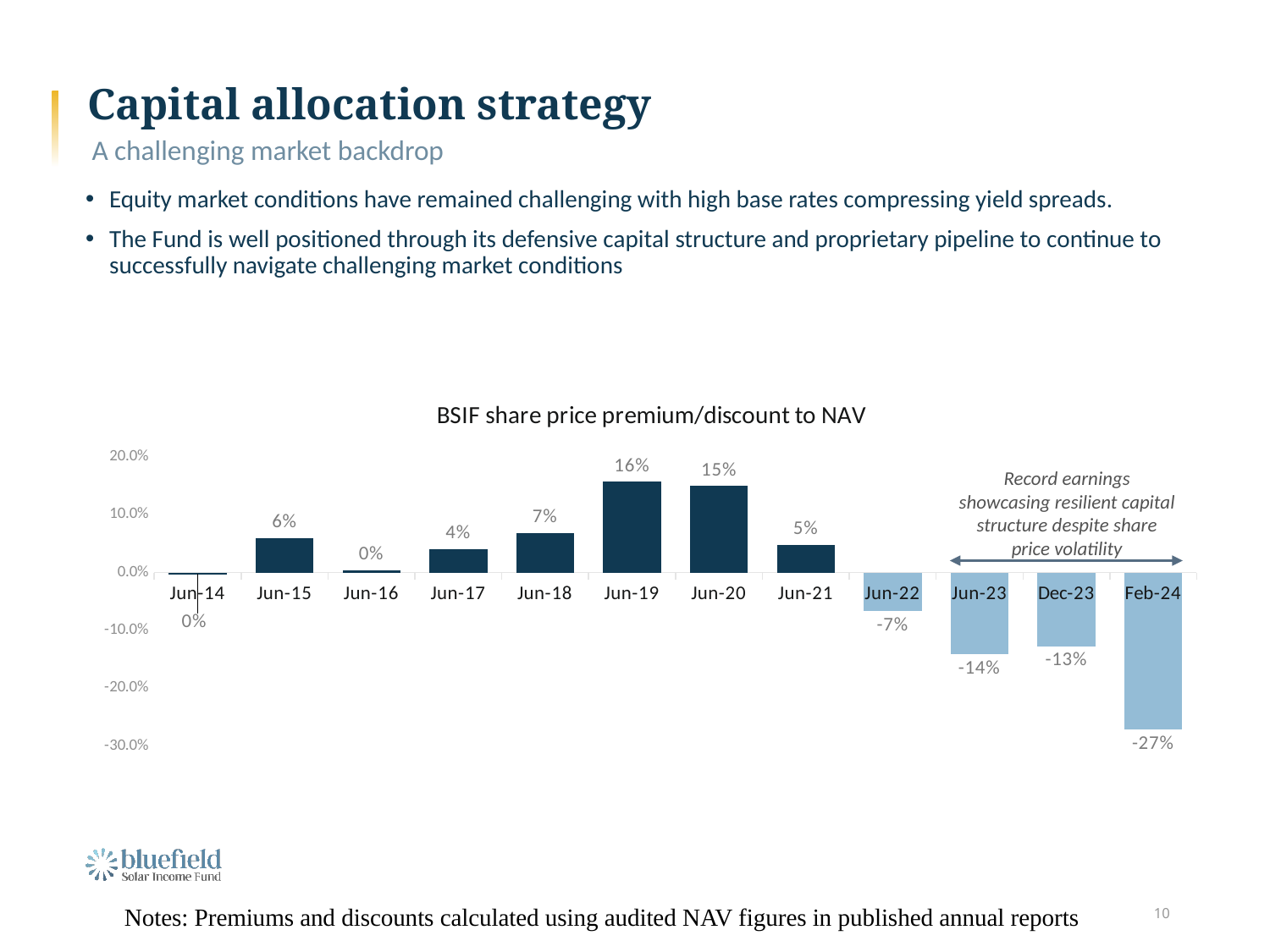
What kind of chart is shown on the slide? Bar chart How many categories are shown on the x axis? 12 What is the value for Jun-19? 16% What is the value for Feb-24? -27% Which is larger, the value for Jun-15 or the value for Jun-17? Jun-15 Which category has the highest value? Jun-19 Which category has the lowest value? Feb-24 Do the values rise or fall from Jun-21 to Feb-24? Fall What is the value for Jun-18? 7% What is the value for Jun-22? -7% What is the title of the chart? BSIF share price premium/discount to NAV What is the difference between the values for Jun-19 and Jun-21? 11%